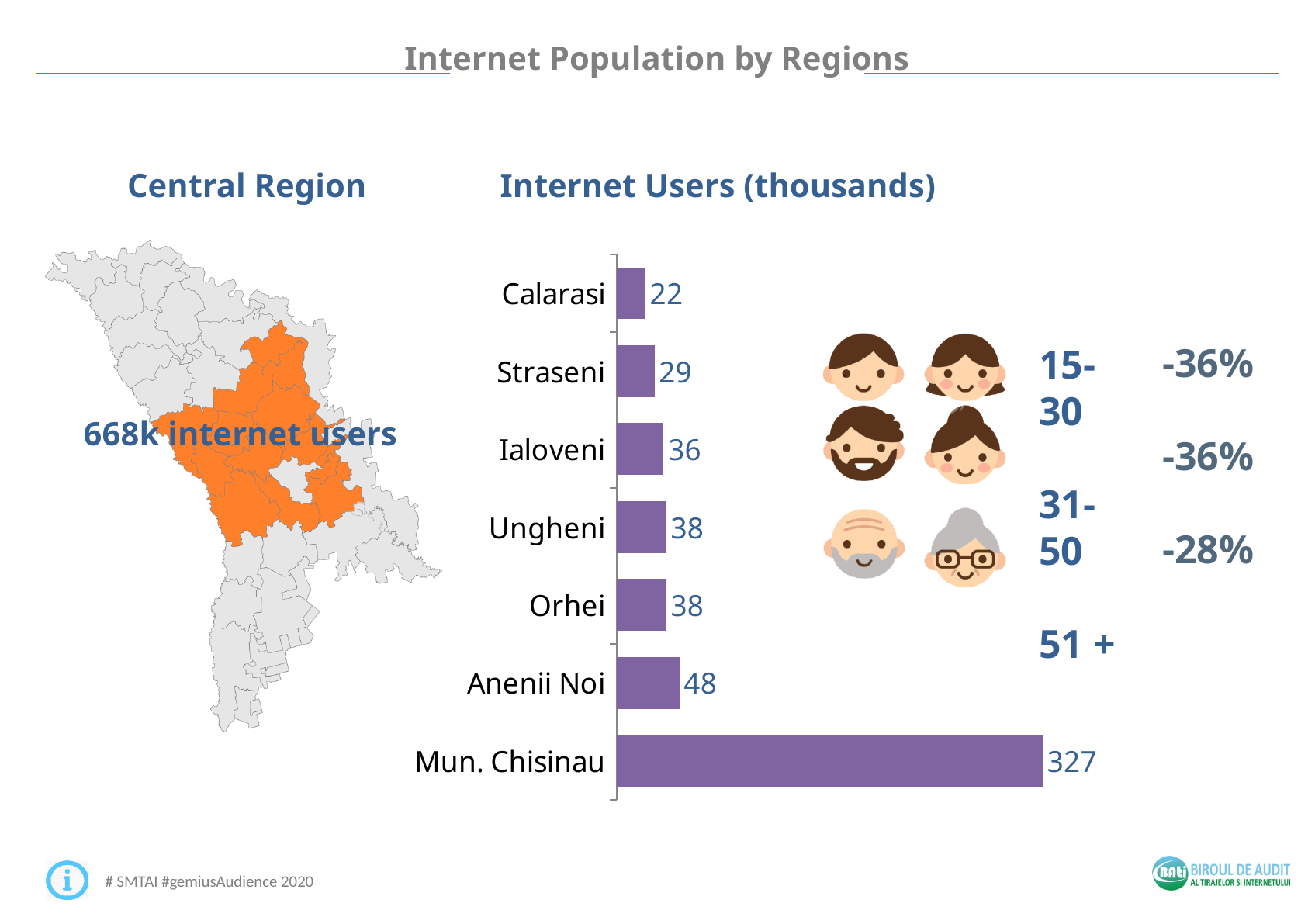
How many categories are shown in the Internet Users (thousands) chart? 7 What is the difference between the values for Anenii Noi and Ialoveni in the Internet Users (thousands) chart? 12 What is the difference between the values for Mun. Chisinau and Calarasi in the Internet Users (thousands) chart? 305 What is the value for Mun. Chisinau in the Internet Users (thousands) chart? 327 What kind of chart is the Internet Users (thousands) chart? bar chart What is the value for Straseni in the Internet Users (thousands) chart? 29 What is the value for Calarasi in the Internet Users (thousands) chart? 22 Which category has the highest value in the Internet Users (thousands) chart? Mun. Chisinau What is the title of the chart on the slide? Internet Users (thousands) Which category has the lowest value in the Internet Users (thousands) chart? Calarasi Which is larger in the Internet Users (thousands) chart, Straseni or Ialoveni? Ialoveni What is the value for Anenii Noi in the Internet Users (thousands) chart? 48